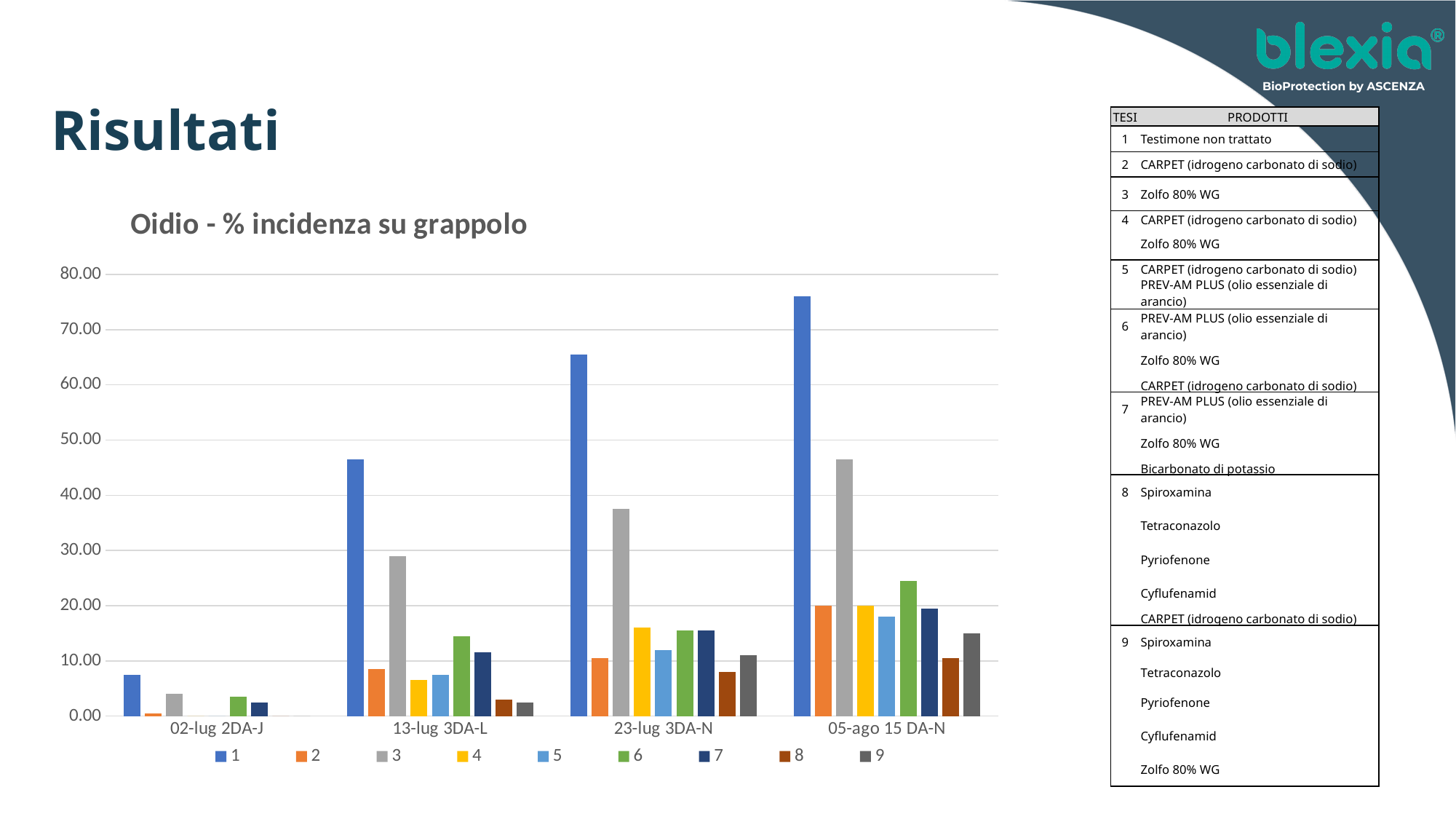
What kind of chart is shown on the slide? bar chart Which series has the lowest value at 05-ago 15 DA-N? 8 At 13-lug 3DA-L, which is larger: the value for series 3 or the value for series 6? 3 Does the value for series 1 rise or fall across the dates from 02-lug 2DA-J to 05-ago 15 DA-N? rise Is the value for series 3 at 23-lug 3DA-N greater or less than 40? less Is the value for series 1 at 05-ago 15 DA-N greater or less than 70? greater Is the value for series 6 at 05-ago 15 DA-N greater or less than 20? greater How many date categories are shown on the x axis of the chart? 4 Which series has the highest value at 05-ago 15 DA-N? 1 How many series does the chart legend list? 9 What is the title of the chart? Oidio - % incidenza su grappolo